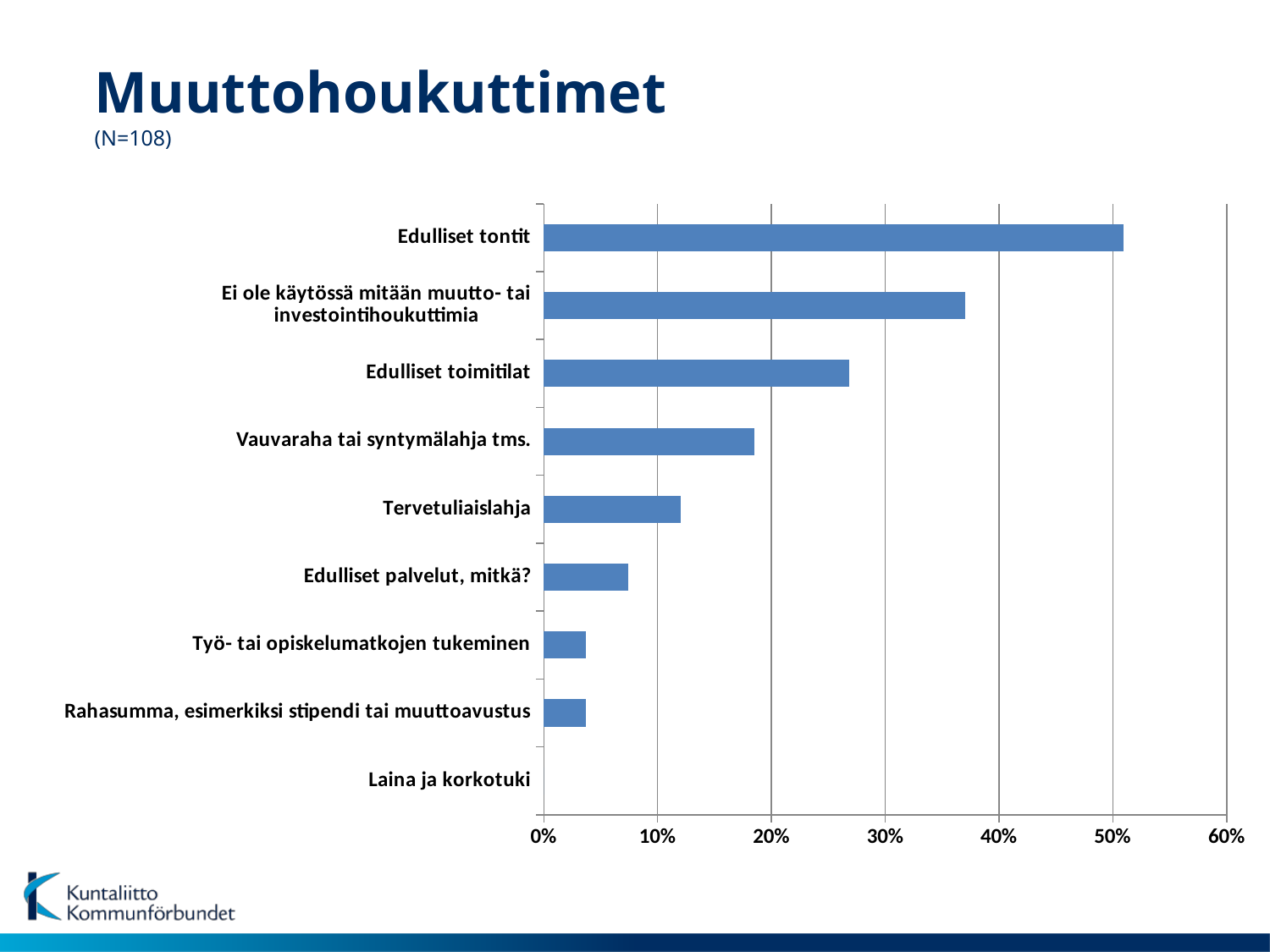
Which category has the lowest value? Laina ja korkotuki What is the title of the chart on the slide? Muuttohoukuttimet What kind of chart is shown on the slide? Bar chart Is the value for 'Ei ole käytössä mitään muutto- tai investointihoukuttimia' greater or less than 40%? less Which is larger, the value for Edulliset toimitilat or the value for Tervetuliaislahja? Edulliset toimitilat Which category has the highest value? Edulliset tontit How many categories are shown in the chart? 9 Is the value for Edulliset toimitilat greater or less than 30%? less Is the value for Edulliset tontit greater or less than 40%? greater What is the value for Laina ja korkotuki? 0%